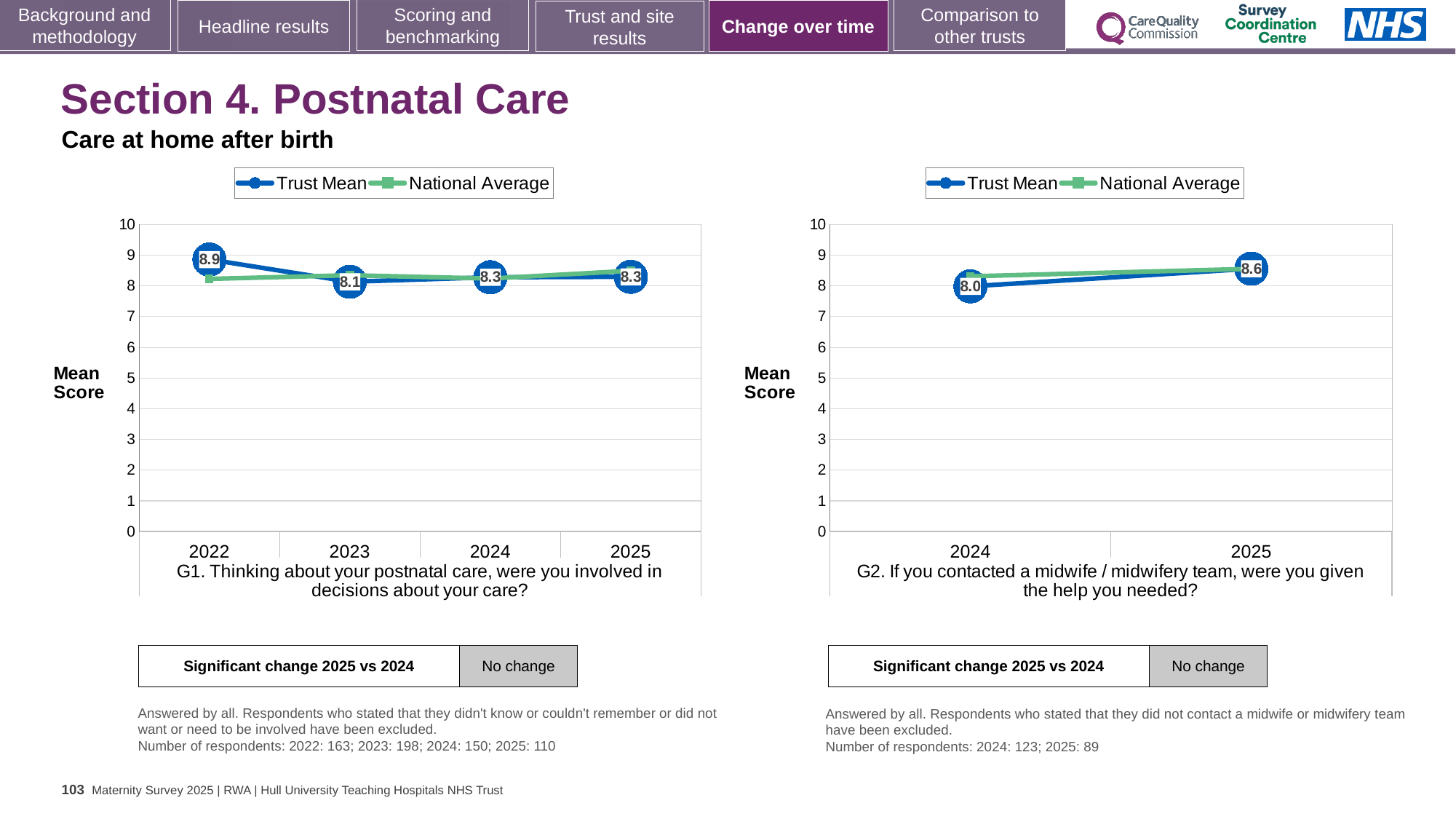
In the G1 chart on the left, what is the Trust Mean score for 2022? 8.9 In the G2 chart on the right, by how much did the Trust Mean score change from 2024 to 2025? 0.6 In the G2 chart on the right, what is the Trust Mean score for 2025? 8.6 In the G2 chart on the right, is the Trust Mean score higher in 2024 or 2025? 2025 In the G2 chart on the right, what is the Trust Mean score for 2024? 8.0 In the G1 chart on the left, what is the Trust Mean score for 2025? 8.3 How many years are shown on the x axis of the G1 chart on the left? 4 In the G1 chart on the left, which year has the highest Trust Mean score? 2022 In the G1 chart on the left, which year has the lowest Trust Mean score? 2023 How many series does the legend of the G2 chart on the right list? 2 In the G1 chart on the left, what is the difference between the Trust Mean scores for 2022 and 2023? 0.8 In the G1 chart on the left, what is the Trust Mean score for 2023? 8.1